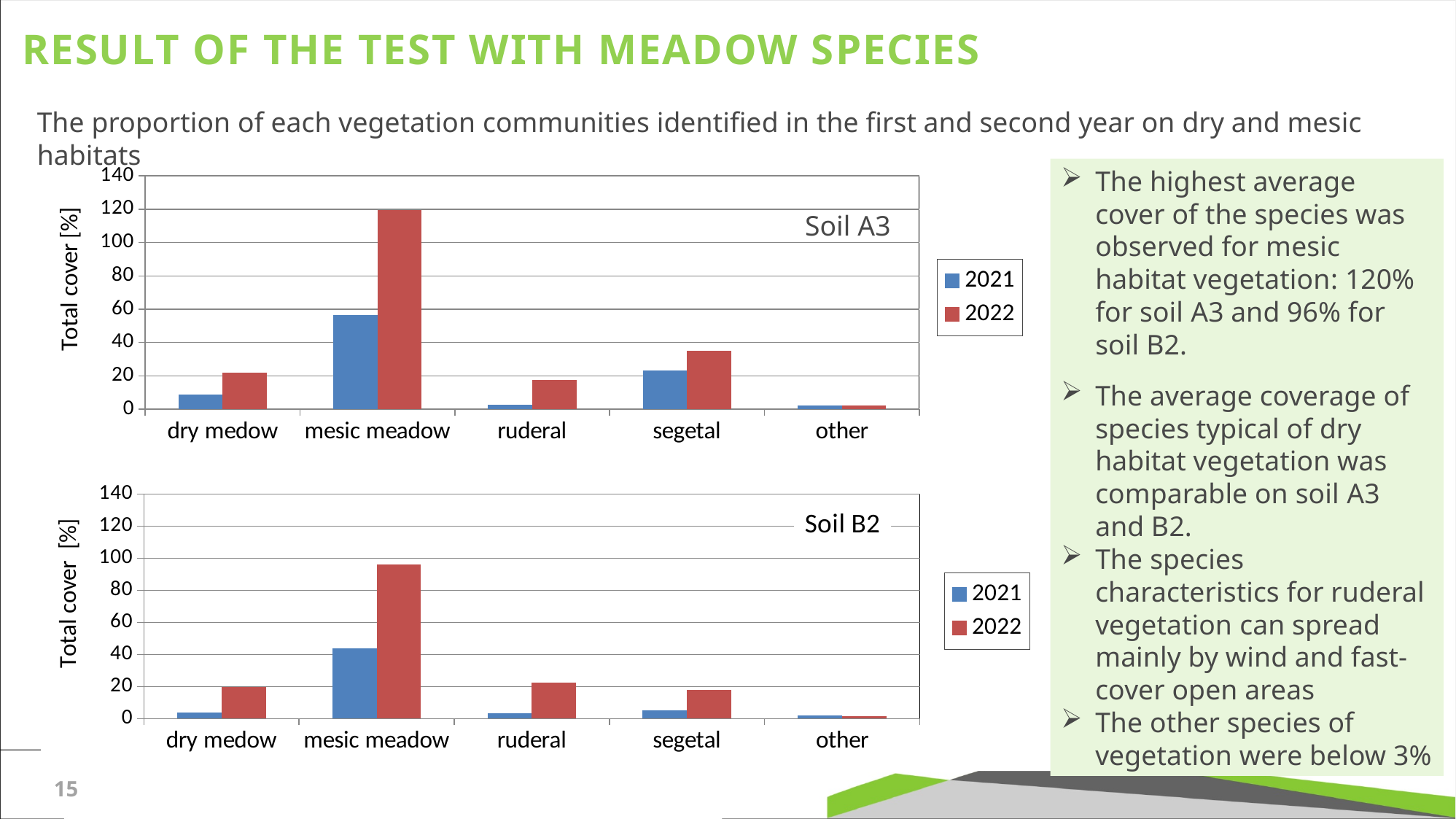
In the Soil B2 chart, is the 2022 value for mesic meadow greater or less than 80? greater In the Soil A3 chart, which category has the highest total cover for 2022? mesic meadow How many series does the legend of the Soil B2 chart list? 2 In the Soil B2 chart, which category has the lowest total cover for 2022? other In the Soil B2 chart, which is larger for ruderal: the 2021 value or the 2022 value? 2022 In the Soil A3 chart, is the 2021 value for mesic meadow greater or less than 40? greater What kind of chart is the Soil A3 chart? bar chart In the Soil A3 chart, which is larger for segetal: the 2021 value or the 2022 value? 2022 What colour represents the 2021 series in the Soil A3 chart? blue How many categories are shown on the x axis of the Soil A3 chart? 5 In the Soil B2 chart, is the 2021 value for segetal greater or less than 20? less In the Soil A3 chart, what is the total cover for mesic meadow in 2022? 120